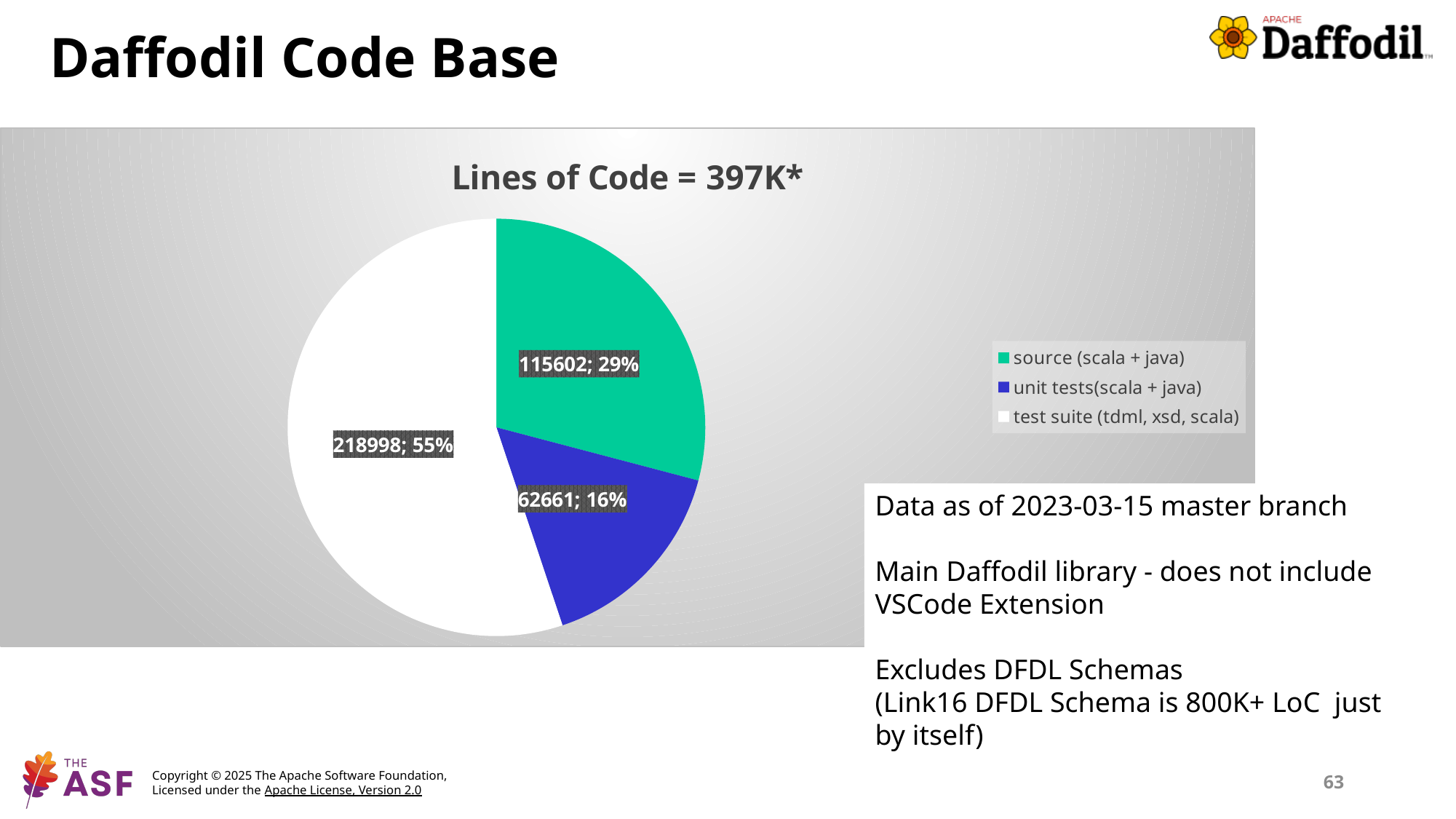
What share of the pie does the unit tests(scala + java) slice represent? 16% How many slices does the pie chart have? 3 How many entries does the legend list? 3 What kind of chart is shown on the slide? pie chart Which category has the largest number of lines of code? test suite (tdml, xsd, scala) How many lines of code are in unit tests(scala + java)? 62661 What is the difference in lines of code between source (scala + java) and unit tests(scala + java)? 52941 What is the title of the chart? Lines of Code = 397K* How many lines of code are in source (scala + java)? 115602 Which category has the smallest number of lines of code? unit tests(scala + java) How many lines of code are in the test suite (tdml, xsd, scala)? 218998 What share of the pie does the test suite (tdml, xsd, scala) slice represent? 55%